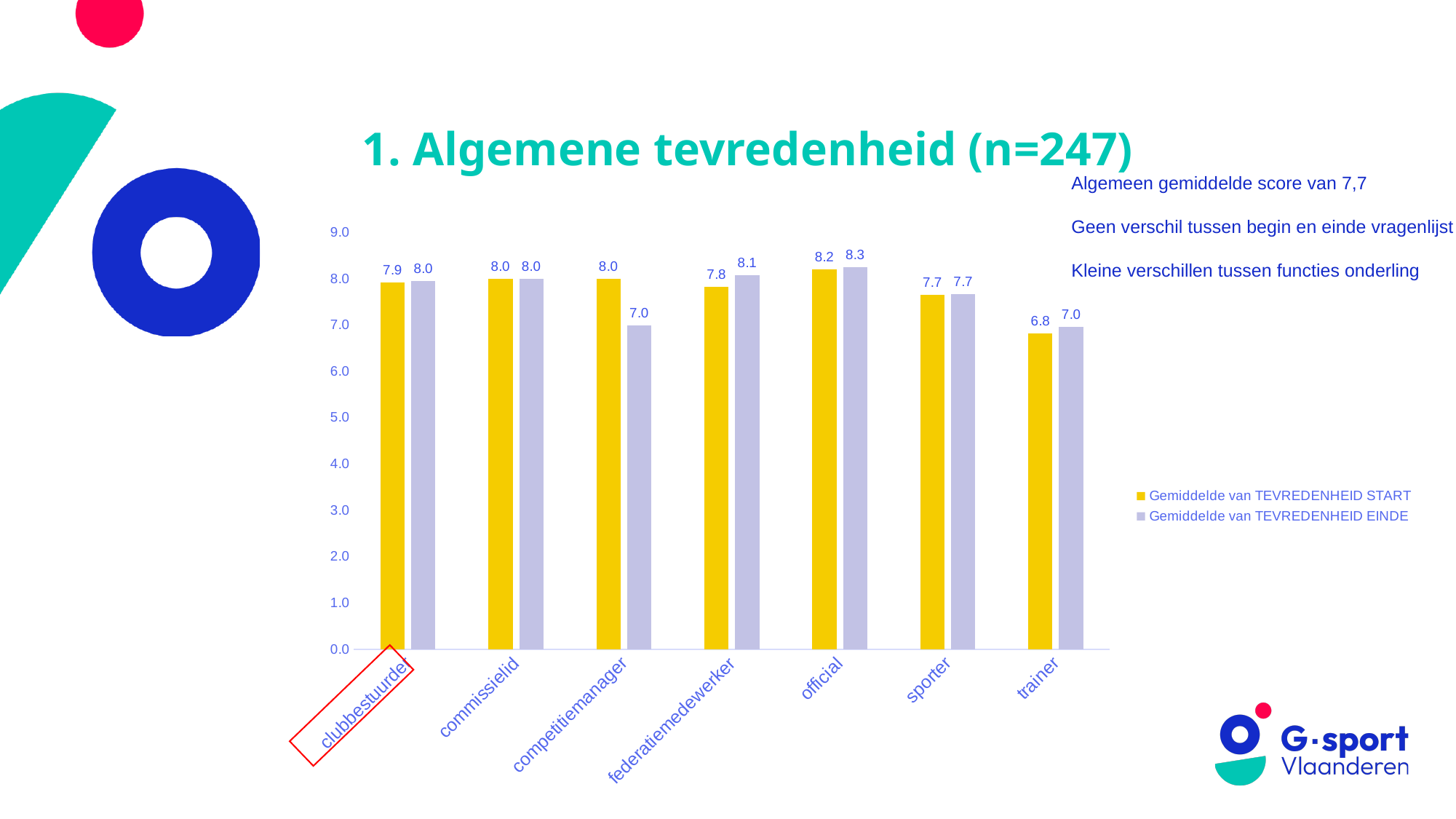
Which category label is outlined with a red box? clubbestuurder Which category has the lowest value for Gemiddelde van TEVREDENHEID EINDE? trainer Which category has the highest value for Gemiddelde van TEVREDENHEID START? official What is the value of Gemiddelde van TEVREDENHEID START for trainer? 6.8 What is the difference between the START and EINDE values for competitiemanager? 1.0 What kind of chart is shown on the slide? bar chart What is the value of Gemiddelde van TEVREDENHEID EINDE for competitiemanager? 7.0 What is the value of Gemiddelde van TEVREDENHEID EINDE for federatiemedewerker? 8.1 How many categories are shown on the x axis? 7 Is the value of Gemiddelde van TEVREDENHEID START for trainer greater or less than 7.0? less Which is larger for federatiemedewerker: the START value or the EINDE value? EINDE How many series does the legend list? 2